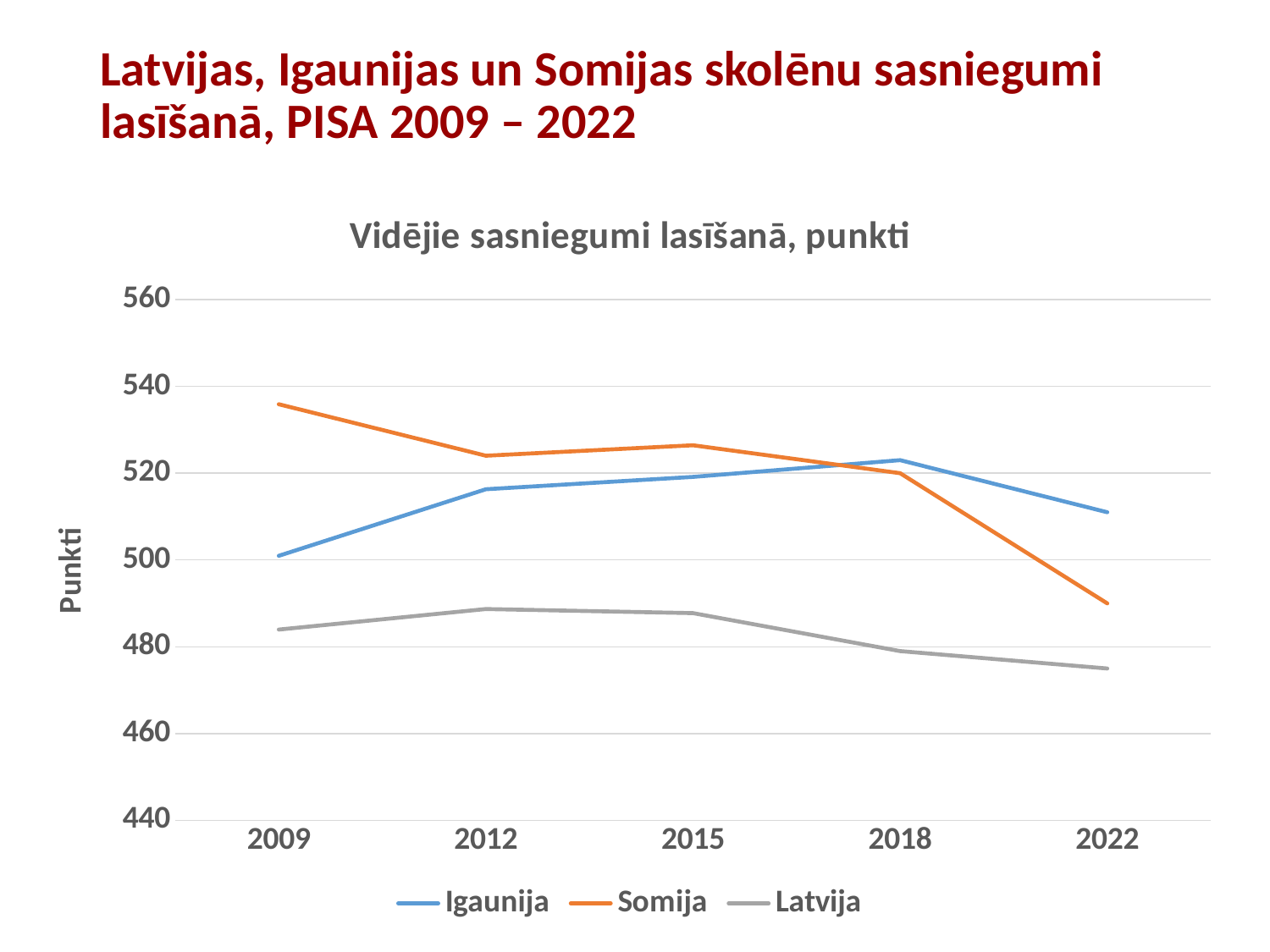
Which is larger in 2022, the value for Igaunija or the value for Somija? Igaunija Which country had the highest reading score in 2009? Somija Is the value for Somija in 2009 greater or less than 520? greater Does the value for Latvija rise or fall from 2015 to 2022? fall How many years are shown on the x axis? 5 Is the value for Latvija in 2022 greater or less than 480? less What kind of chart is shown on the slide? line chart How many series does the legend list? 3 Which country had the lowest reading score in 2022? Latvija In which year was Somija's reading score highest? 2009 What is the title of the chart? Vidējie sasniegumi lasīšanā, punkti Is the value for Igaunija in 2022 greater or less than 500? greater